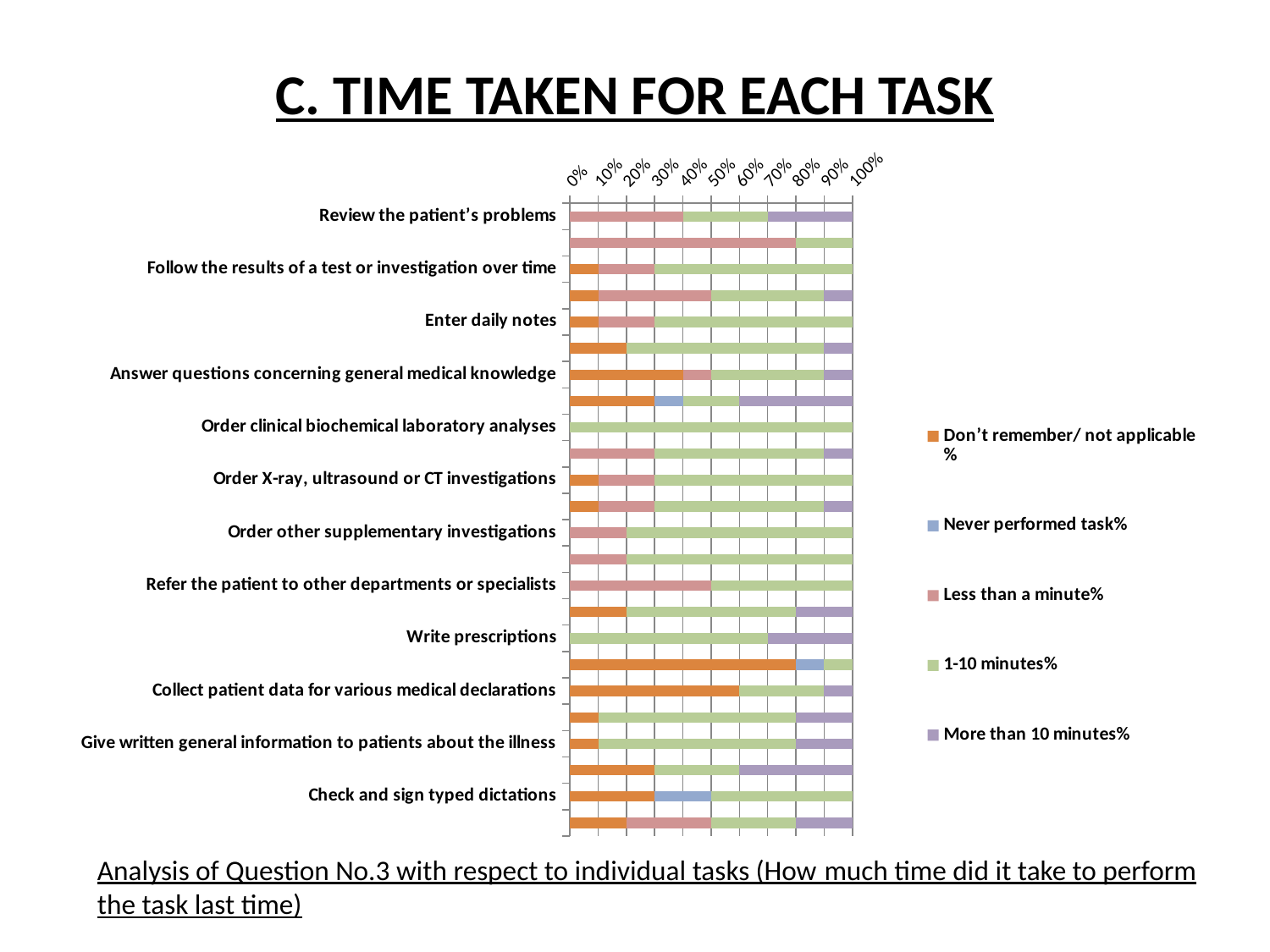
How many series does the legend list? 5 Is the "Less than a minute%" value for "Order X-ray, ultrasound or CT investigations" greater or less than 40%? less For "Write prescriptions", which is larger: the "1-10 minutes%" value or the "More than 10 minutes%" value? 1-10 minutes% Which colour represents the "Never performed task%" series in the legend? Blue Is the "1-10 minutes%" value for "Order clinical biochemical laboratory analyses" greater or less than 80%? greater Is the "Less than a minute%" value for "Review the patient's problems" greater or less than 30%? greater What kind of chart is shown on the slide? Stacked bar chart What is the title of the chart? C. TIME TAKEN FOR EACH TASK